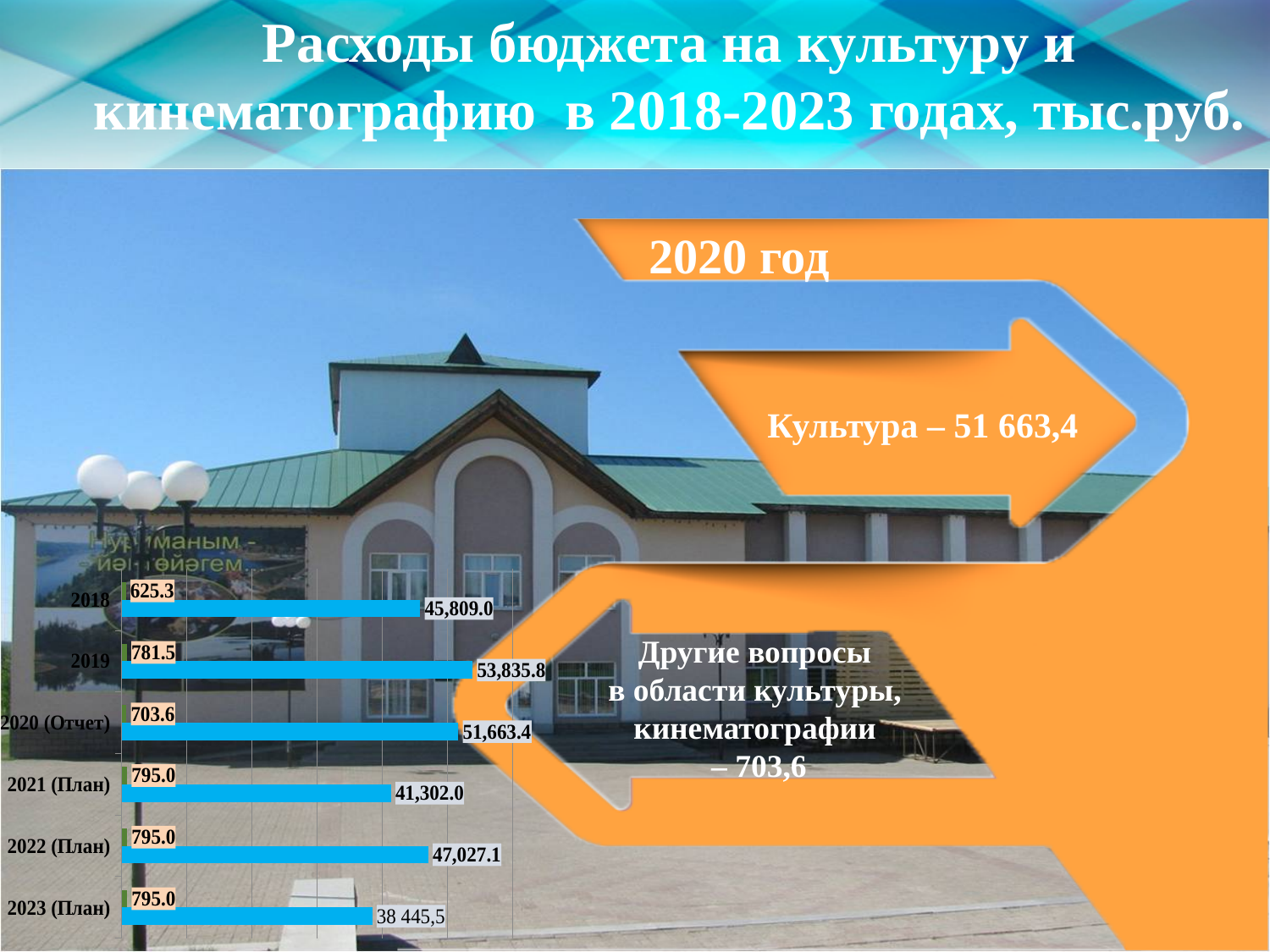
What is the value of the blue bar for 2019? 53,835.8 What is the value of the small green bar for 2020 (Отчет)? 703.6 Which category has the lowest value for the small green bar? 2018 What is the value of the small green bar for 2018? 625.3 What is the difference between the blue bar values for 2018 and 2021 (План)? 4,507.0 How many categories (years) are shown on the chart? 6 What is the value of the blue bar for 2023 (План)? 38 445,5 What is the difference between the blue bar values for 2019 and 2020 (Отчет)? 2,172.4 Which is larger, the blue bar value for 2022 (План) or for 2018? 2022 (План) Which category has the highest blue bar value? 2019 Which category has the lowest blue bar value? 2023 (План) What type of chart is shown on the slide? Bar chart